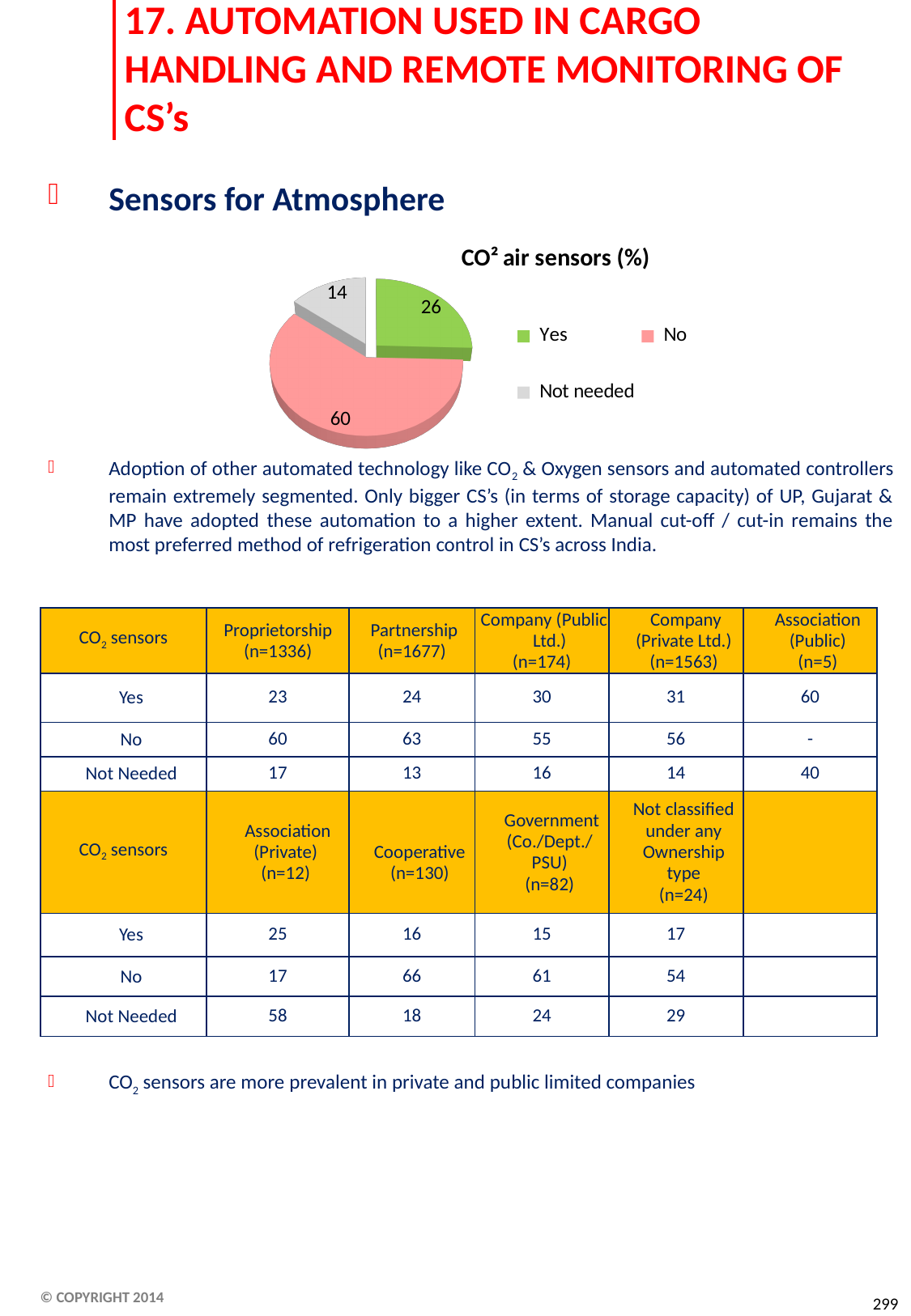
What is the value for the 'No' slice in the CO² air sensors chart? 60 What is the title of the chart? CO² air sensors (%) What is the difference between the 'No' and 'Yes' values in the CO² air sensors chart? 34 How many slices does the CO² air sensors pie chart have? 3 What is the value for the 'Not needed' slice in the CO² air sensors chart? 14 What colour is the 'No' slice in the CO² air sensors chart? pink Which is larger in the CO² air sensors chart, 'Yes' or 'Not needed'? Yes Which category has the smallest slice in the CO² air sensors chart? Not needed Which category has the largest slice in the CO² air sensors chart? No What is the value for the 'Yes' slice in the CO² air sensors chart? 26 What kind of chart is shown on the slide? pie chart How many entries does the legend of the CO² air sensors chart list? 3